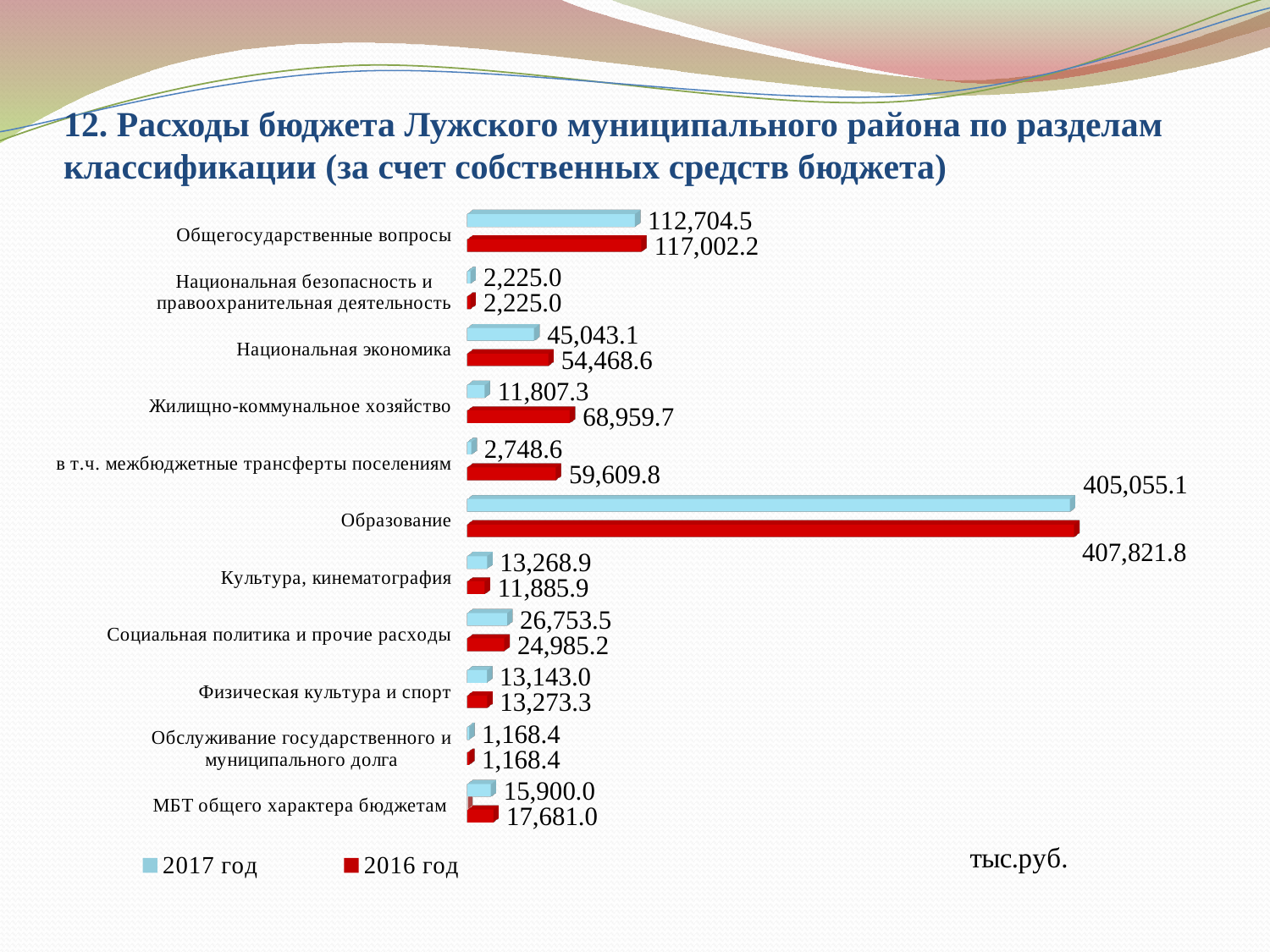
Which is larger for Культура, кинематография: the 2017 год value or the 2016 год value? 2017 год What is the 2016 год value for Жилищно-коммунальное хозяйство? 68,959.7 What kind of chart is shown on the slide? Bar chart Which category has the highest 2016 год value? Образование Which category has the lowest 2017 год value? Обслуживание государственного и муниципального долга What is the 2017 год value for Образование? 405,055.1 What is the difference between the 2016 год and 2017 год values for Жилищно-коммунальное хозяйство? 57,152.4 What is the difference between the 2016 год and 2017 год values for Национальная экономика? 9,425.5 How many categories are shown on the chart? 11 How many series does the legend list? 2 What is the 2017 год value for Социальная политика и прочие расходы? 26,753.5 What is the 2016 год value for МБТ общего характера бюджетам? 17,681.0